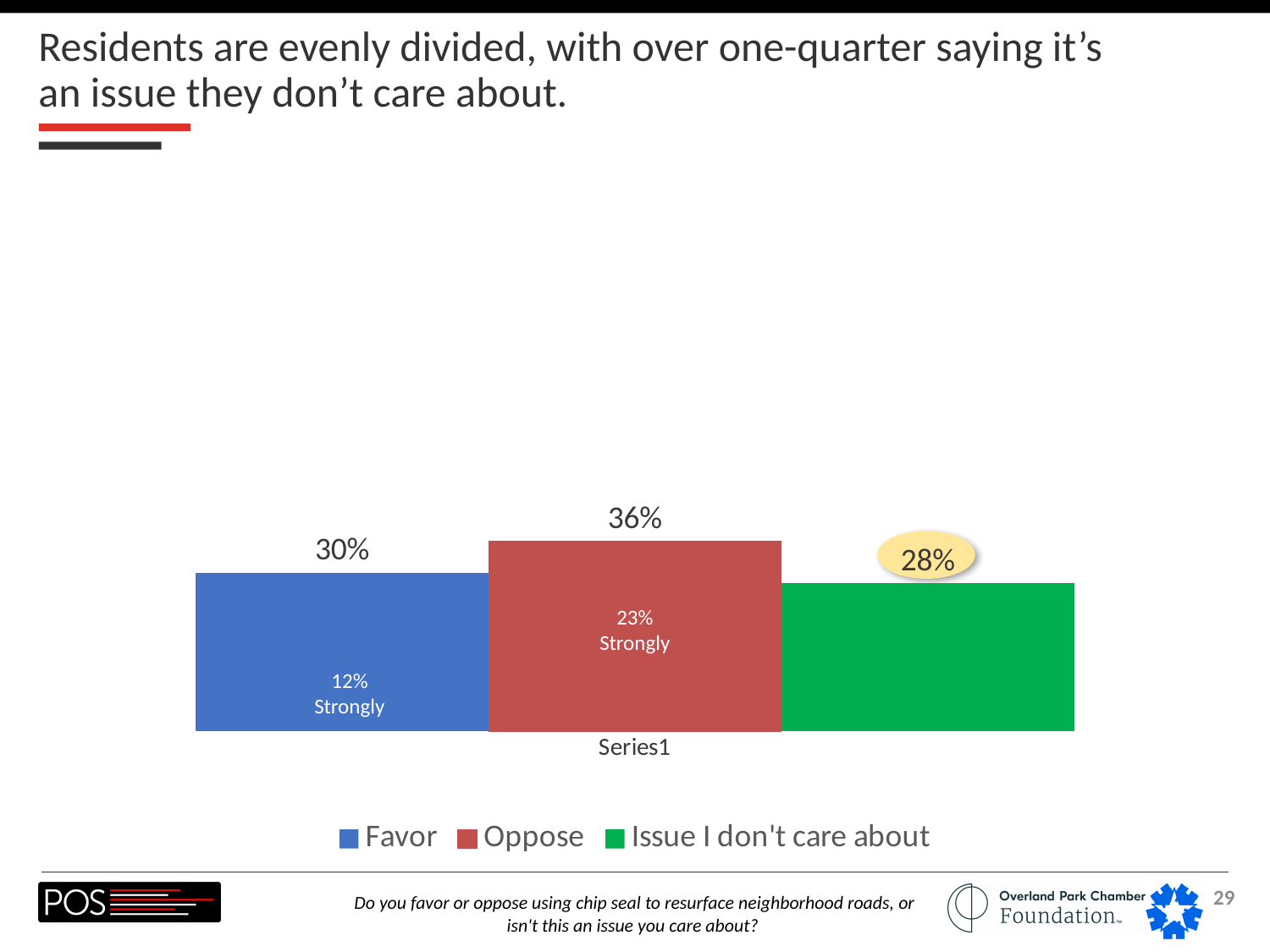
What is the difference in percentage points between Oppose and Favor? 6 Which response has the highest percentage? Oppose What percentage of residents favor using chip seal to resurface neighborhood roads? 30% What is the difference in percentage points between those who strongly oppose and those who strongly favor? 11 What percentage of residents oppose using chip seal? 36% How many series does the legend list? 3 What type of chart is shown on the slide? Bar chart What percentage of residents say it is an issue they don't care about? 28% What percentage of residents strongly favor using chip seal? 12% What percentage of residents strongly oppose using chip seal? 23% Which is larger, the percentage who favor or the percentage who say it is an issue they don't care about? Favor Which response has the lowest percentage? Issue I don't care about